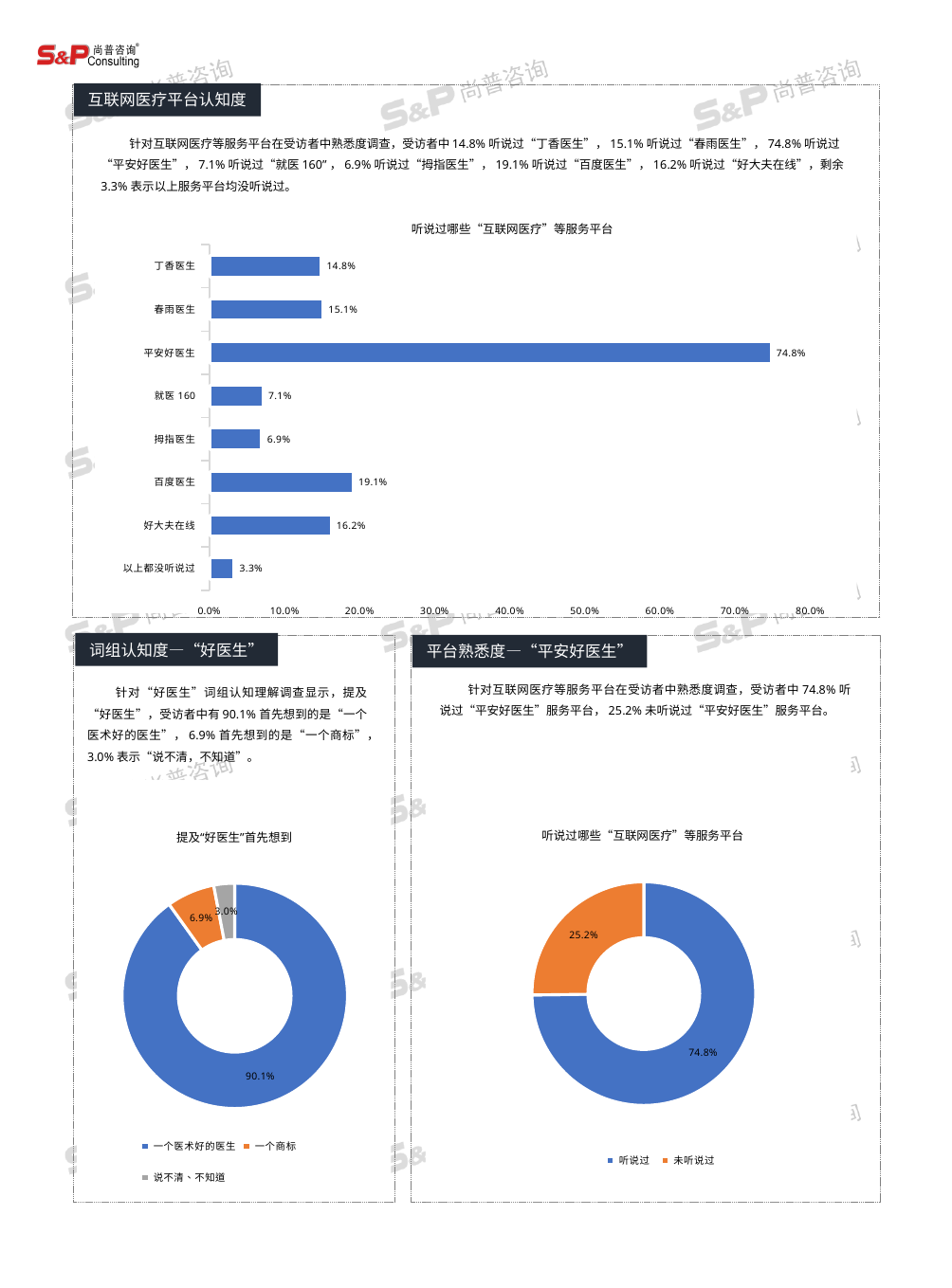
In the top bar chart, which category has the lowest value? 以上都没听说过 In the bottom-right donut chart, what is the value for 未听说过? 25.2% How many entries does the legend of the bottom-right donut chart list? 2 In the top bar chart, what is the difference between the values for 好大夫在线 and 春雨医生? 1.1% In the top bar chart, what is the value for 百度医生? 19.1% In the bottom-left donut chart titled 提及“好医生”首先想到, what share is labelled for 一个医术好的医生? 90.1% In the top bar chart, which category has the highest value? 平安好医生 In the bottom-left donut chart titled 提及“好医生”首先想到, what is the value for 一个商标? 6.9% How many categories are shown in the top bar chart? 8 What kind of chart is the top chart on the slide? Bar chart In the top bar chart, what is the value for 平安好医生? 74.8% In the top bar chart, which is larger, the value for 就医 160 or the value for 拇指医生? 就医 160